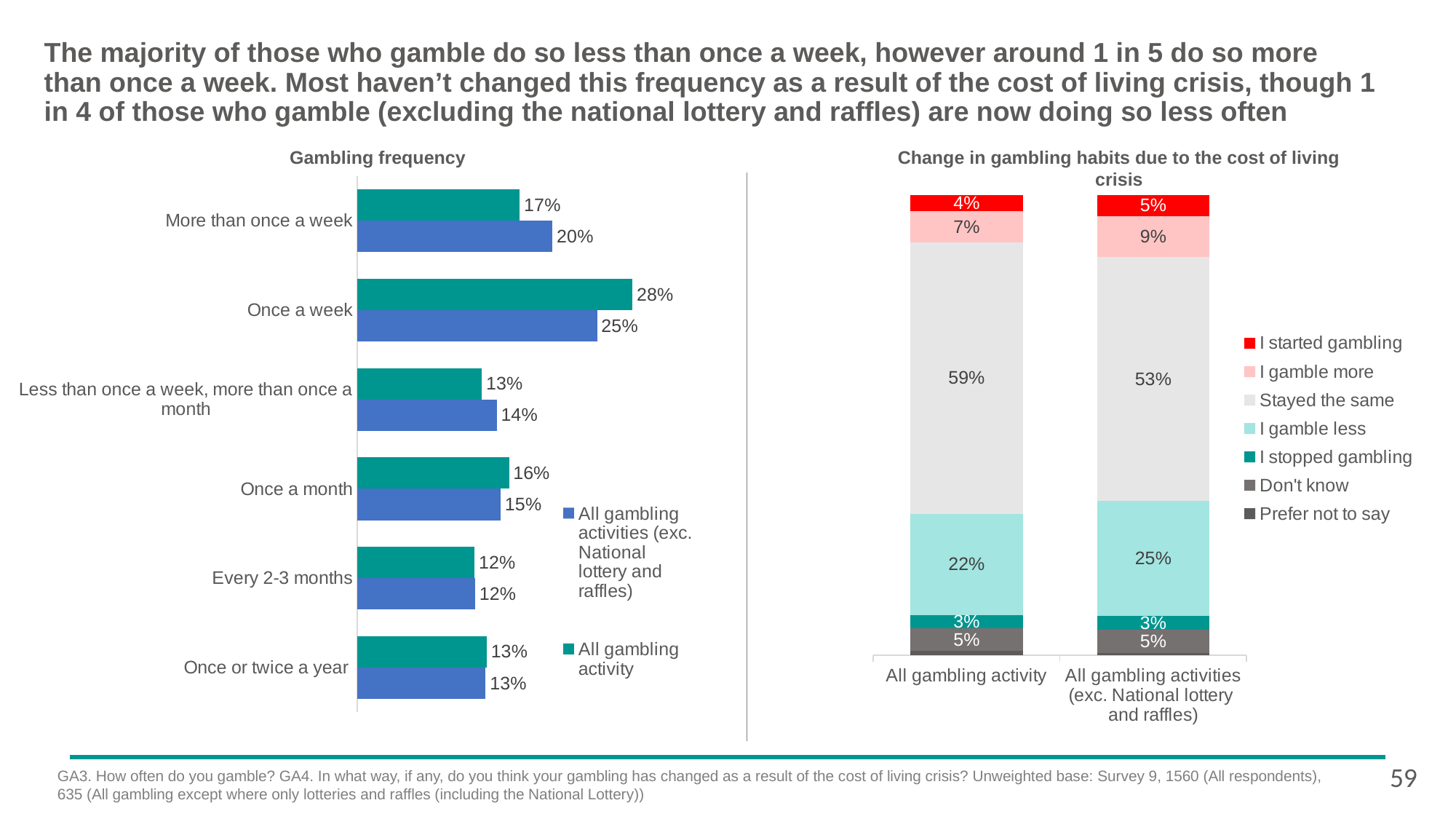
In the Gambling frequency chart, how many frequency categories are shown? 6 What type of chart is the Gambling frequency chart? Bar chart In the Change in gambling habits chart, what percentage of All gambling activities (exc. National lottery and raffles) respondents said they gamble less? 25% In the Gambling frequency chart, which frequency category has the lowest value for All gambling activities (exc. National lottery and raffles)? Every 2-3 months In the Gambling frequency chart, how many series does the legend list? 2 In the Change in gambling habits chart, how many entries does the legend list? 7 In the Gambling frequency chart, which frequency category has the highest value for All gambling activity? Once a week In the Gambling frequency chart, what percentage of All gambling activity respondents gamble once a week? 28% In the Change in gambling habits chart, what percentage of All gambling activity respondents said their gambling stayed the same? 59% In the Change in gambling habits chart, which bar has the larger 'I gamble more' value: All gambling activity or All gambling activities (exc. National lottery and raffles)? All gambling activities (exc. National lottery and raffles) In the Gambling frequency chart, what is the difference between the All gambling activity and the All gambling activities (exc. National lottery and raffles) values for 'Once a week'? 3% In the Gambling frequency chart, what is the value for 'More than once a week' for All gambling activities (exc. National lottery and raffles)? 20%